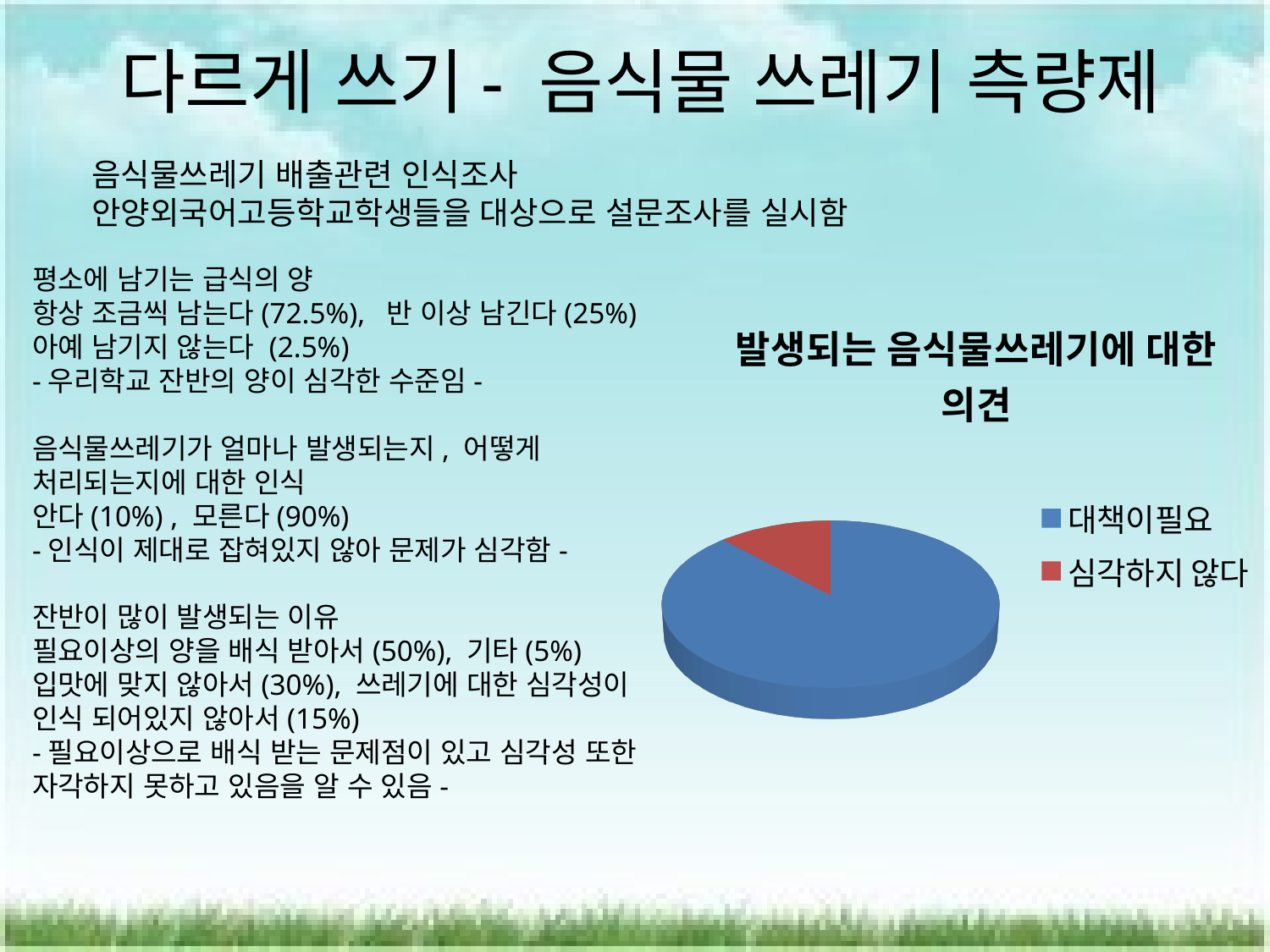
How many entries does the legend of the pie chart list? 2 Which category has the smallest slice in the pie chart? 심각하지 않다 What kind of chart is shown on the slide? pie chart What colour is the 심각하지 않다 slice in the pie chart? red In the pie chart, which slice is larger: 대책이필요 or 심각하지 않다? 대책이필요 Which category has the largest slice in the pie chart? 대책이필요 What is the title of the pie chart? 발생되는 음식물쓰레기에 대한 의견 How many slices does the pie chart have? 2